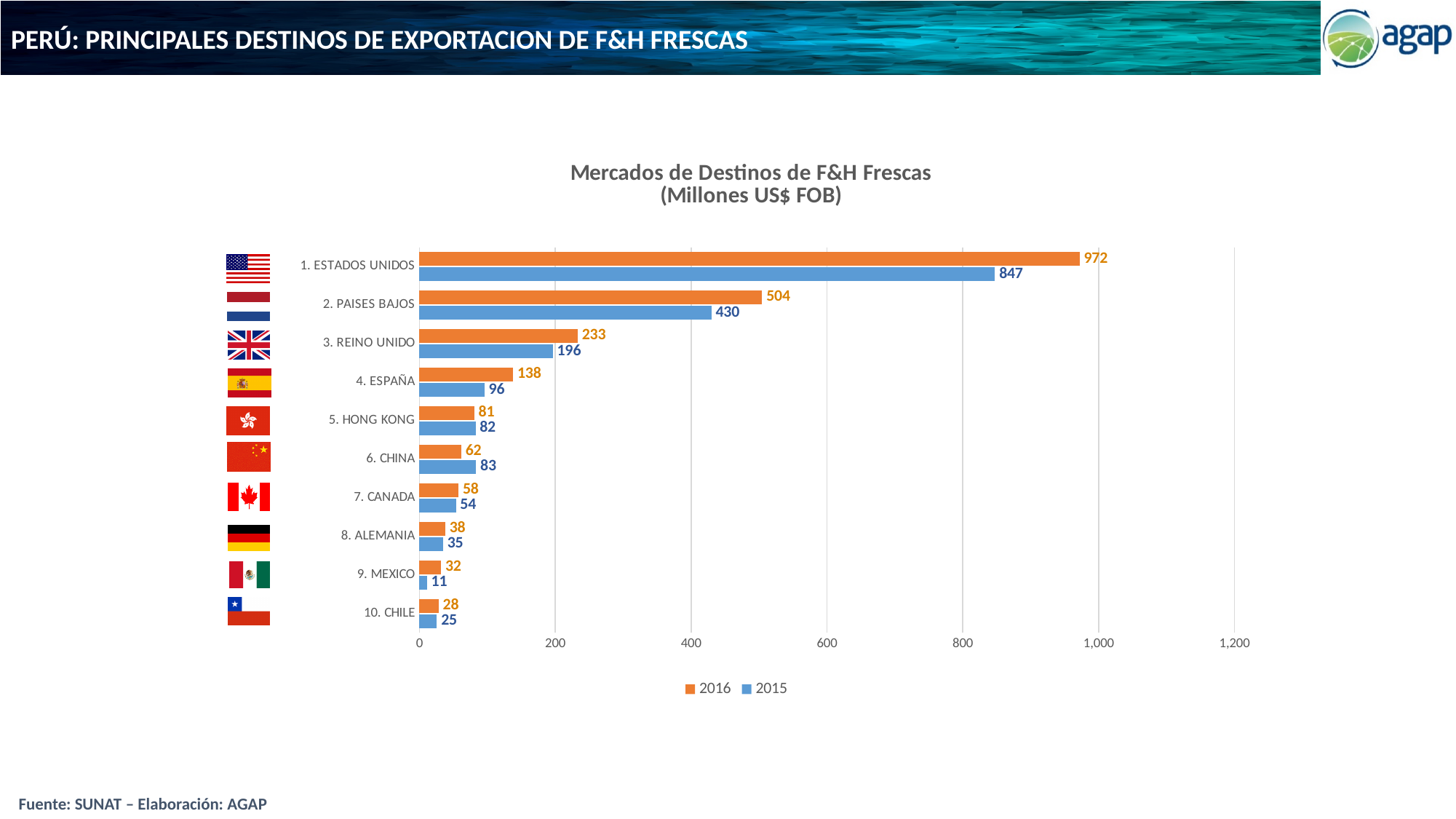
What kind of chart is shown on the slide? Bar chart How many destination countries are shown in the chart? 10 Which destination has the highest 2016 value? 1. Estados Unidos Is the 2016 value for Reino Unido greater or less than 200? greater How many series does the legend list? 2 Which is larger for China: the 2016 value or the 2015 value? 2015 Which destination has the lowest 2015 value? 9. Mexico What is the 2015 value for Paises Bajos? 430 What is the 2016 value for Estados Unidos? 972 What is the 2016 value for España? 138 What is the title of the chart? Mercados de Destinos de F&H Frescas (Millones US$ FOB) What is the difference between the 2016 and 2015 values for Estados Unidos? 125